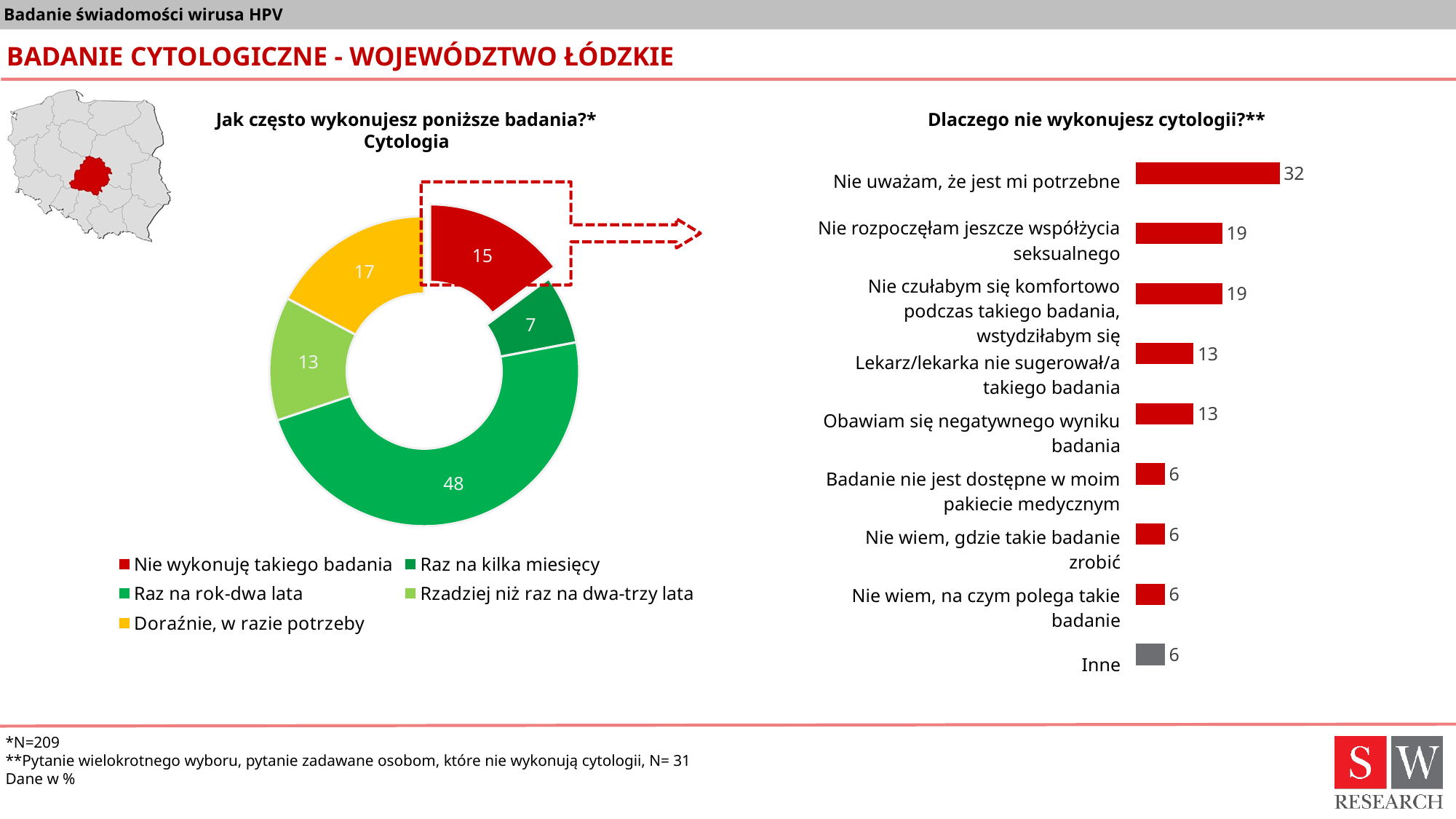
What type of chart is 'Jak często wykonujesz poniższe badania? Cytologia'? Pie (donut) chart What type of chart is 'Dlaczego nie wykonujesz cytologii?'? Bar chart In the chart 'Dlaczego nie wykonujesz cytologii?', what is the value for 'Lekarz/lekarka nie sugerował/a takiego badania'? 13 How many categories does the legend of the chart 'Jak często wykonujesz poniższe badania? Cytologia' list? 5 In the chart 'Dlaczego nie wykonujesz cytologii?', how many categories are shown? 9 In the chart 'Jak często wykonujesz poniższe badania? Cytologia', which category has the smallest value? Raz na kilka miesięcy In the chart 'Jak często wykonujesz poniższe badania? Cytologia', what is the value for 'Nie wykonuję takiego badania'? 15 In the chart 'Jak często wykonujesz poniższe badania? Cytologia', what is the difference between 'Doraźnie, w razie potrzeby' and 'Rzadziej niż raz na dwa-trzy lata'? 4 In the chart 'Jak często wykonujesz poniższe badania? Cytologia', which category has the largest value? Raz na rok-dwa lata In the chart 'Dlaczego nie wykonujesz cytologii?', what is the value for 'Nie uważam, że jest mi potrzebne'? 32 In the chart 'Dlaczego nie wykonujesz cytologii?', what is the difference between 'Nie uważam, że jest mi potrzebne' and 'Nie rozpoczęłam jeszcze współżycia seksualnego'? 13 In the chart 'Jak często wykonujesz poniższe badania? Cytologia', what is the value for 'Raz na rok-dwa lata'? 48